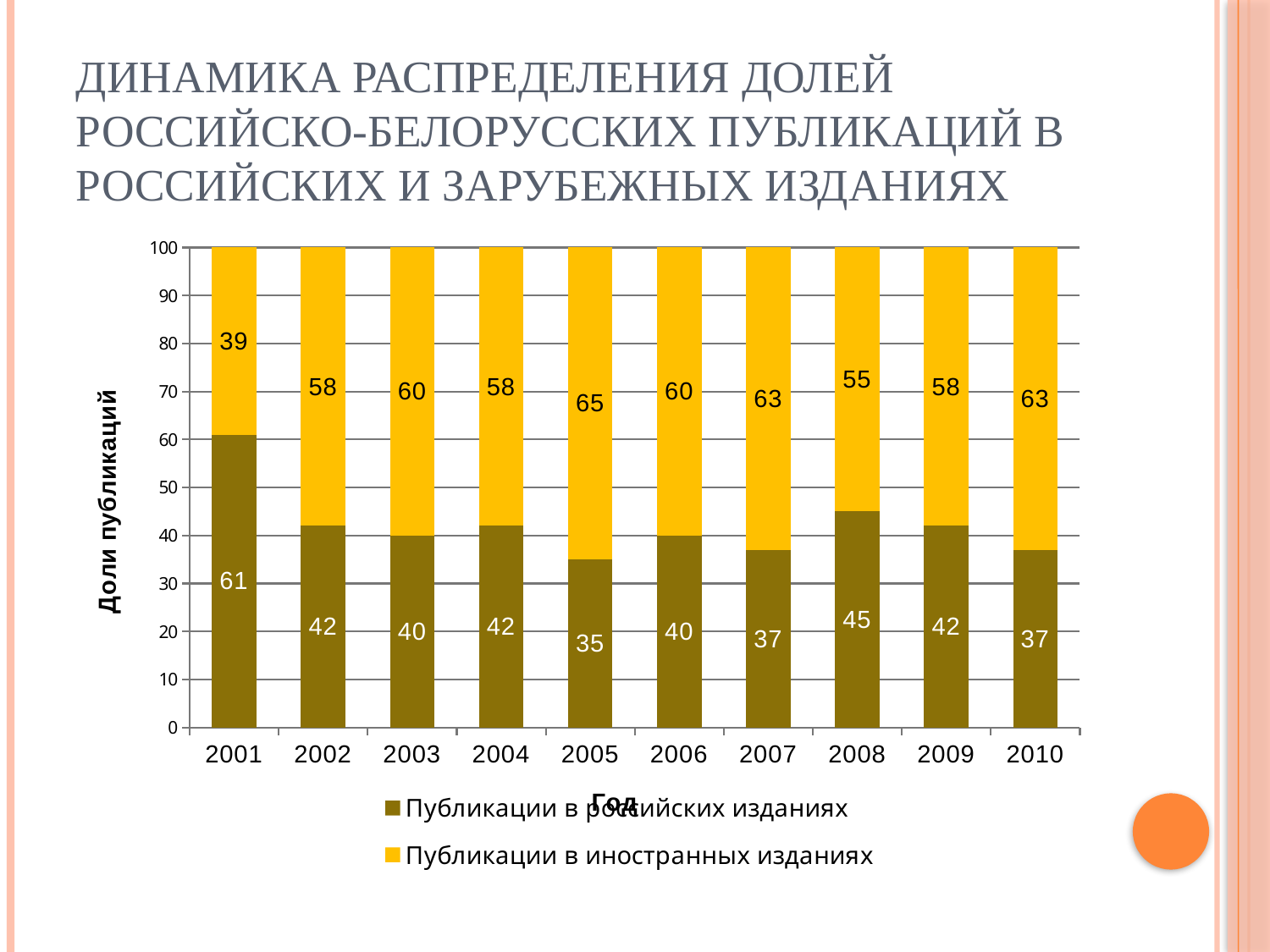
In which year is the value for Публикации в российских изданиях lowest? 2005 What is the value for Публикации в иностранных изданиях in 2005? 65 How many years are shown on the x axis? 10 How many series does the legend list? 2 What is the label of the y axis? Доли публикаций What is the difference between the Публикации в иностранных изданиях values for 2005 and 2001? 26 Which is larger in 2007: Публикации в российских изданиях or Публикации в иностранных изданиях? Публикации в иностранных изданиях In which year is the value for Публикации в российских изданиях highest? 2001 What kind of chart is shown on the slide? Stacked bar chart What is the value for Публикации в российских изданиях in 2008? 45 What is the value for Публикации в российских изданиях in 2001? 61 What is the total of the stacked bar for 2004? 100